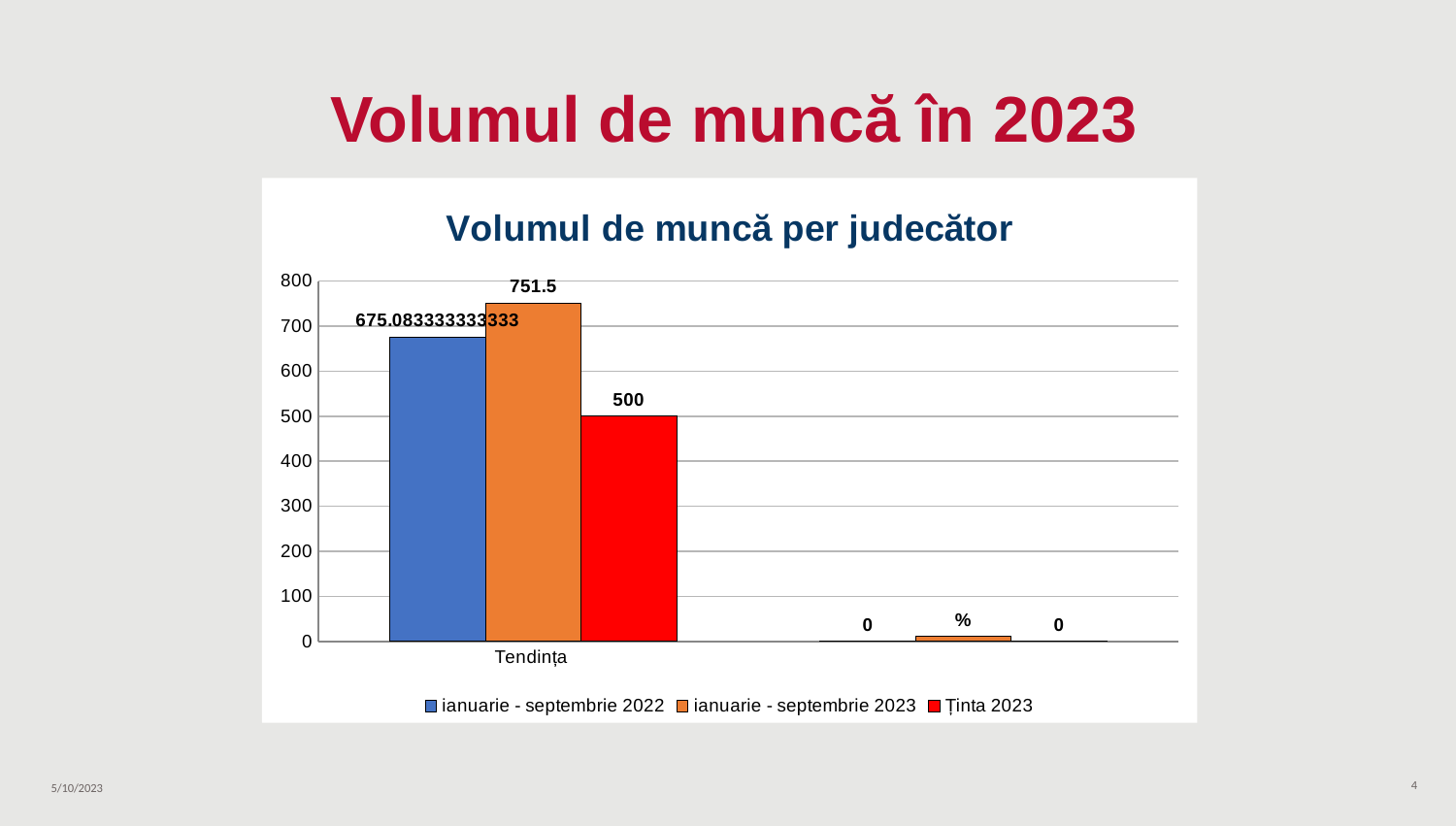
Which series is shown in red? Ținta 2023 What is the value for Ținta 2023 in the Tendința category? 500 What is the difference between the ianuarie - septembrie 2023 value and the Ținta 2023 value in the Tendința category? 251.5 Which series has the lowest value in the Tendința category? Ținta 2023 What is the value for ianuarie - septembrie 2023 in the Tendința category? 751.5 Is the value for ianuarie - septembrie 2022 in the Tendința category greater or less than 600? greater Which series has the highest value in the Tendința category? ianuarie - septembrie 2023 What kind of chart is shown on the slide? bar chart What is the title of the chart? Volumul de muncă per judecător How many series does the legend list? 3 In the Tendința category, which is larger: the value for ianuarie - septembrie 2022 or the value for Ținta 2023? ianuarie - septembrie 2022 What is the value for ianuarie - septembrie 2022 in the Tendința category? 675.083333333333